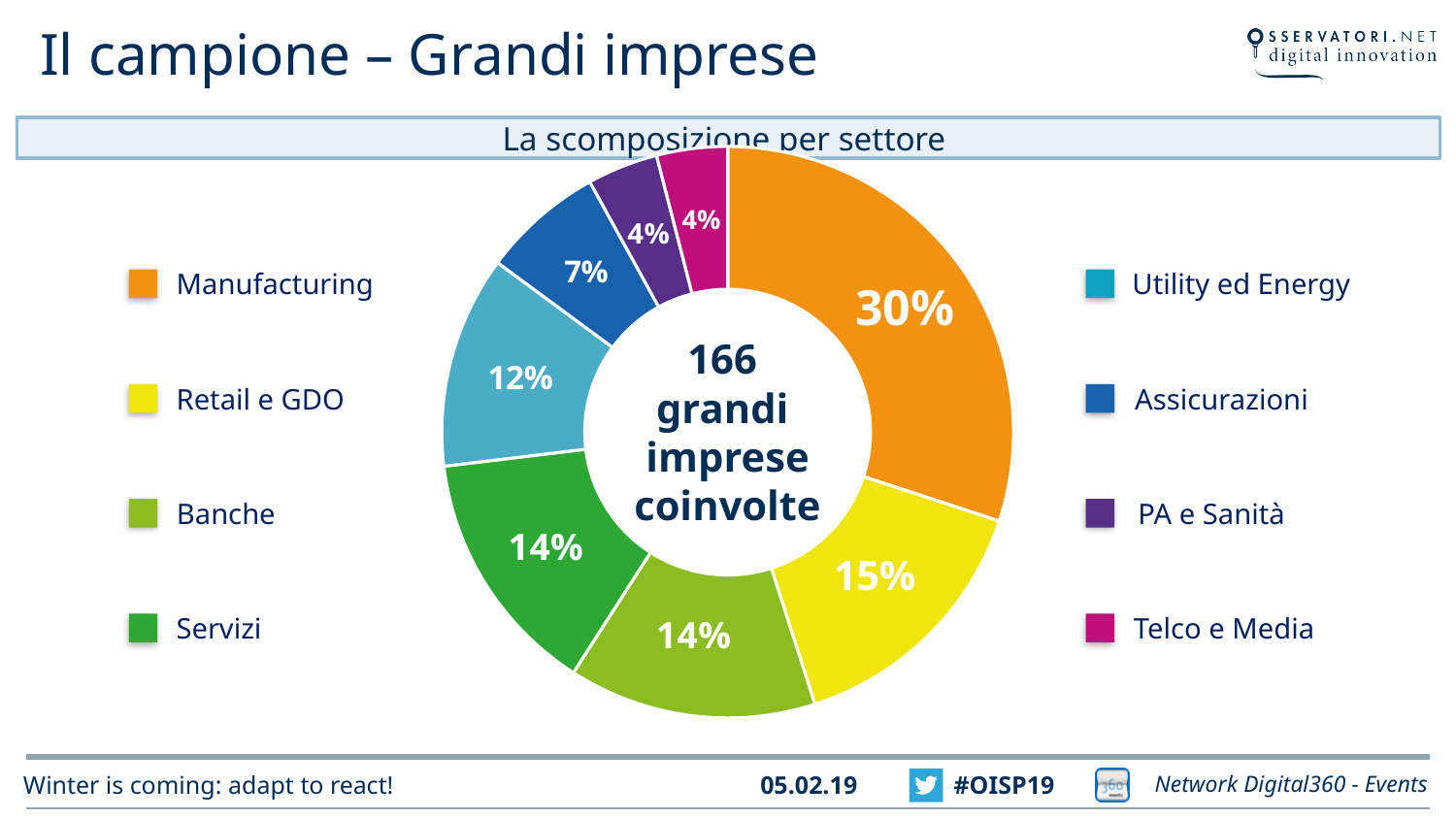
Which sector has the largest share of the sample? Manufacturing How many large companies are involved according to the text in the centre of the chart? 166 What is the difference in percentage points between Manufacturing and Retail e GDO? 15 How many sectors are shown in the chart? 8 What share of the sample does Manufacturing represent? 30% What percentage is shown for Assicurazioni? 7% Which has a larger share, Banche or Assicurazioni? Banche What percentage is shown for Telco e Media? 4% What is the difference in percentage points between Utility ed Energy and Assicurazioni? 5 What percentage is shown for Utility ed Energy? 12% What percentage is shown for Retail e GDO? 15% What type of chart is shown on the slide? Donut (pie) chart